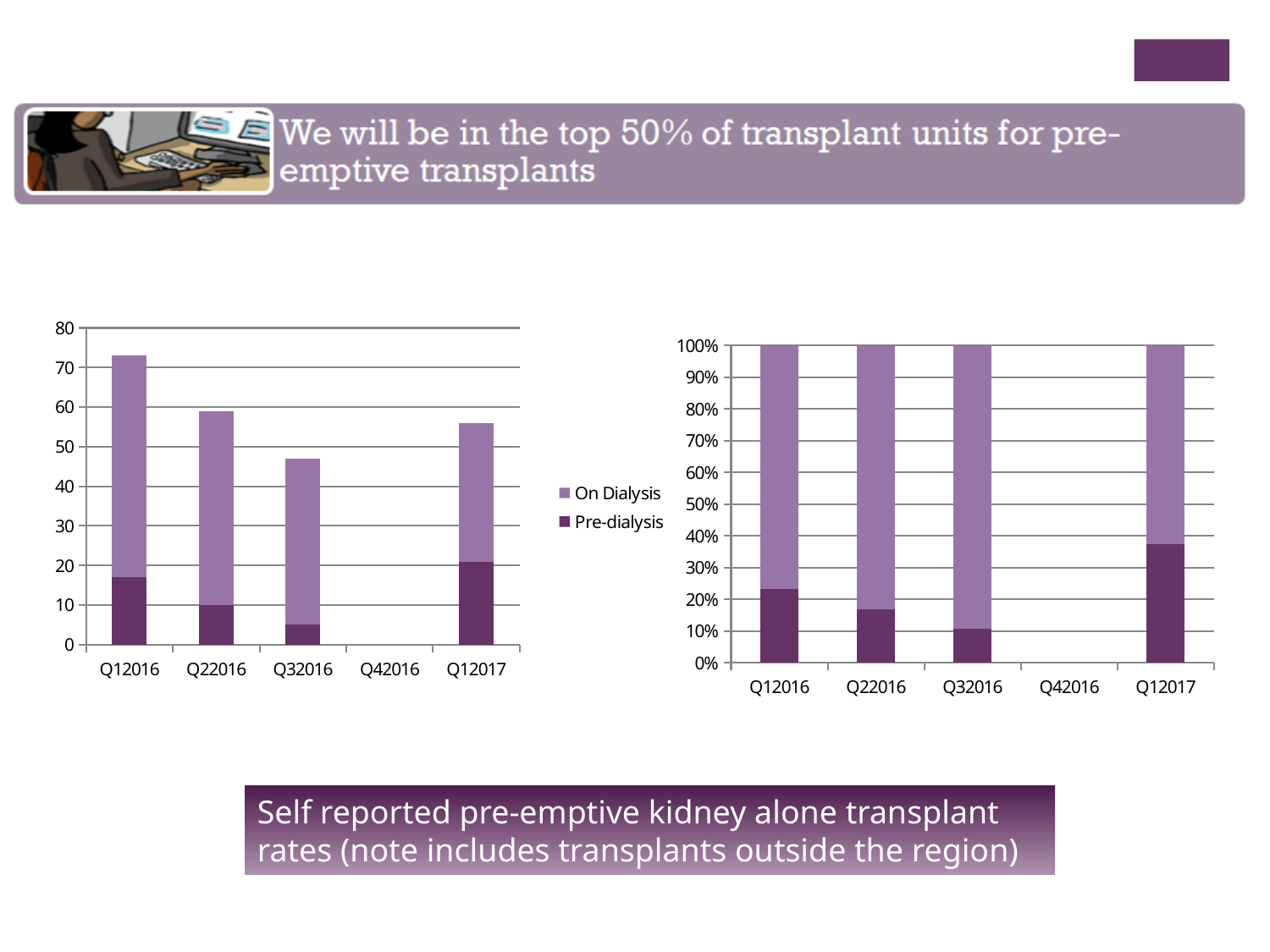
How many quarters are labelled on the x axis of the left chart? 5 In the left chart, is the total bar for Q12016 greater or less than 60? greater What are the two series named in the legend? On Dialysis and Pre-dialysis In the right chart, which quarter has the largest Pre-dialysis share? Q12017 In the right chart, is the Pre-dialysis share for Q32016 greater or less than 20%? less How many series does the legend list? 2 In the left chart, is the Pre-dialysis value for Q12017 greater or less than 10? greater What kind of chart is the chart on the left of the slide? stacked bar chart In the left chart, which is larger, the total bar for Q22016 or the total bar for Q32016? Q22016 In the left chart, which quarter has the tallest total bar? Q12016